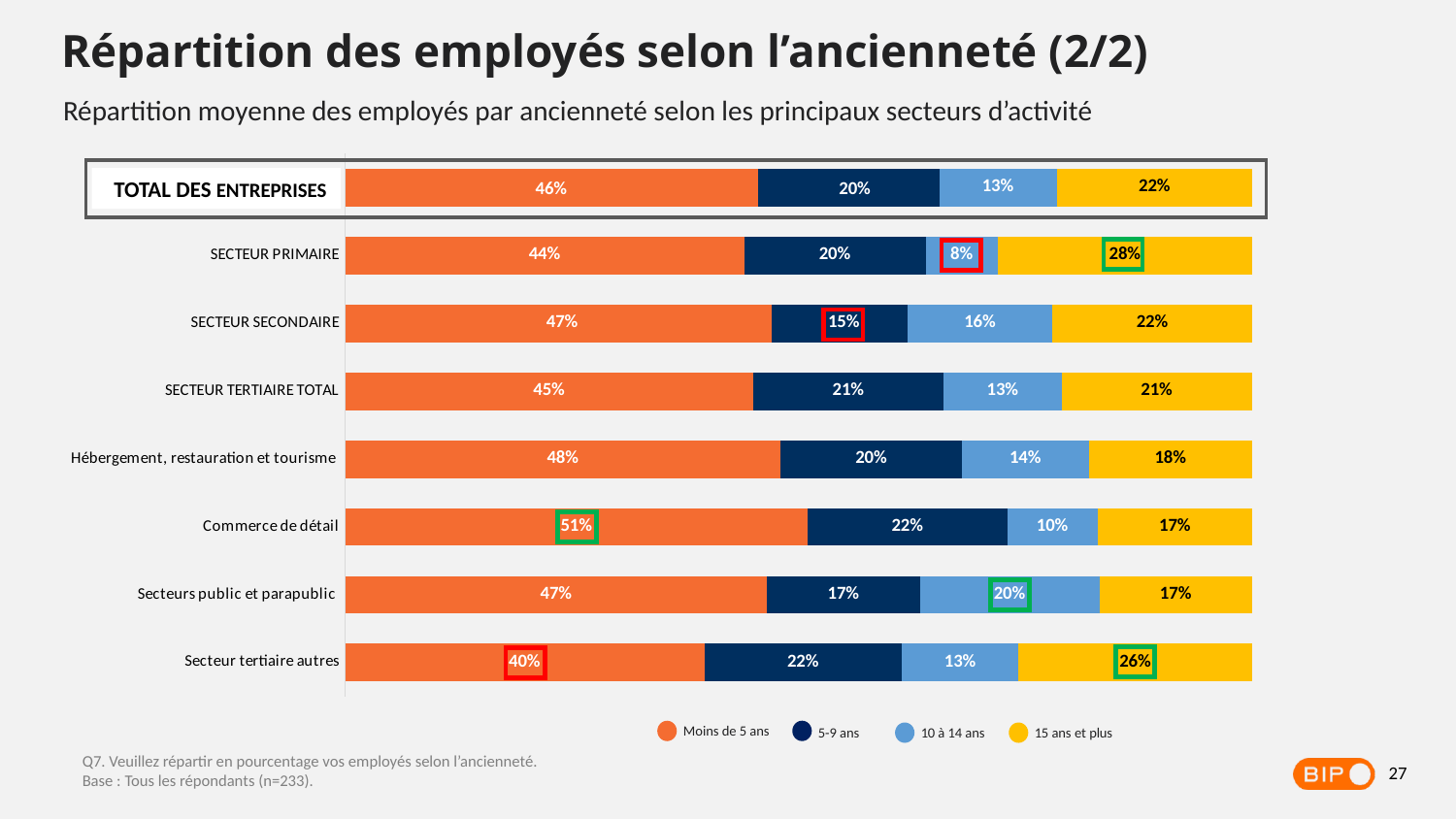
How many series does the legend list? 4 What is the value for "5-9 ans" in the "TOTAL DES ENTREPRISES" bar? 20% Which is larger: the "5-9 ans" value for "SECTEUR SECONDAIRE" or for "Secteur tertiaire autres"? Secteur tertiaire autres What is the difference between the "15 ans et plus" values for "SECTEUR PRIMAIRE" and "Commerce de détail"? 11% What is the value for "15 ans et plus" in the "SECTEUR PRIMAIRE" bar? 28% What is the value for "Moins de 5 ans" in the "Commerce de détail" bar? 51% What is the value for "10 à 14 ans" in the "Secteurs public et parapublic" bar? 20% How many categories (bars) are shown in the chart? 8 Which category has the highest value for "Moins de 5 ans"? Commerce de détail What kind of chart is shown on the slide? Stacked bar chart Which category has the lowest value for "Moins de 5 ans"? Secteur tertiaire autres Which category has the lowest value for "10 à 14 ans"? SECTEUR PRIMAIRE